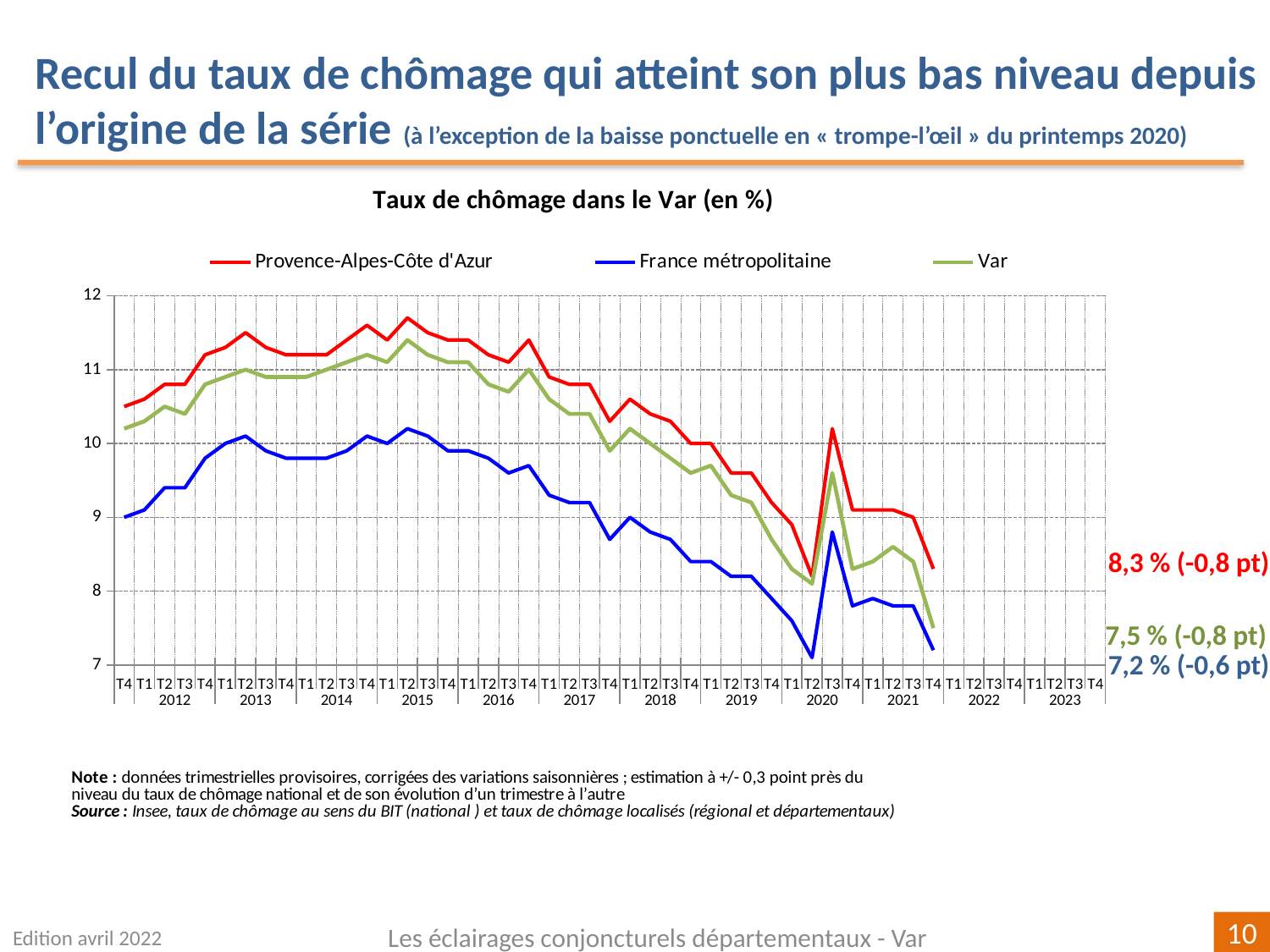
What is the latest value shown for France métropolitaine? 7,2 % How many series does the legend list? 3 What is the title of the chart? Taux de chômage dans le Var (en %) What kind of chart is shown on the slide? line chart Which series has the lowest values across the whole period? France métropolitaine What change in points is indicated next to the latest value for France métropolitaine? -0,6 pt Is the value for Provence-Alpes-Côte d'Azur in T2 2015 greater or less than 11? greater At the latest point, which is higher: Provence-Alpes-Côte d'Azur or Var? Provence-Alpes-Côte d'Azur Do the values for Var rise or fall between 2015 and 2019? fall What is the difference between the latest values for Provence-Alpes-Côte d'Azur and France métropolitaine? 1,1 What is the latest value shown for Var? 7,5 % What is the latest value shown for Provence-Alpes-Côte d'Azur? 8,3 %